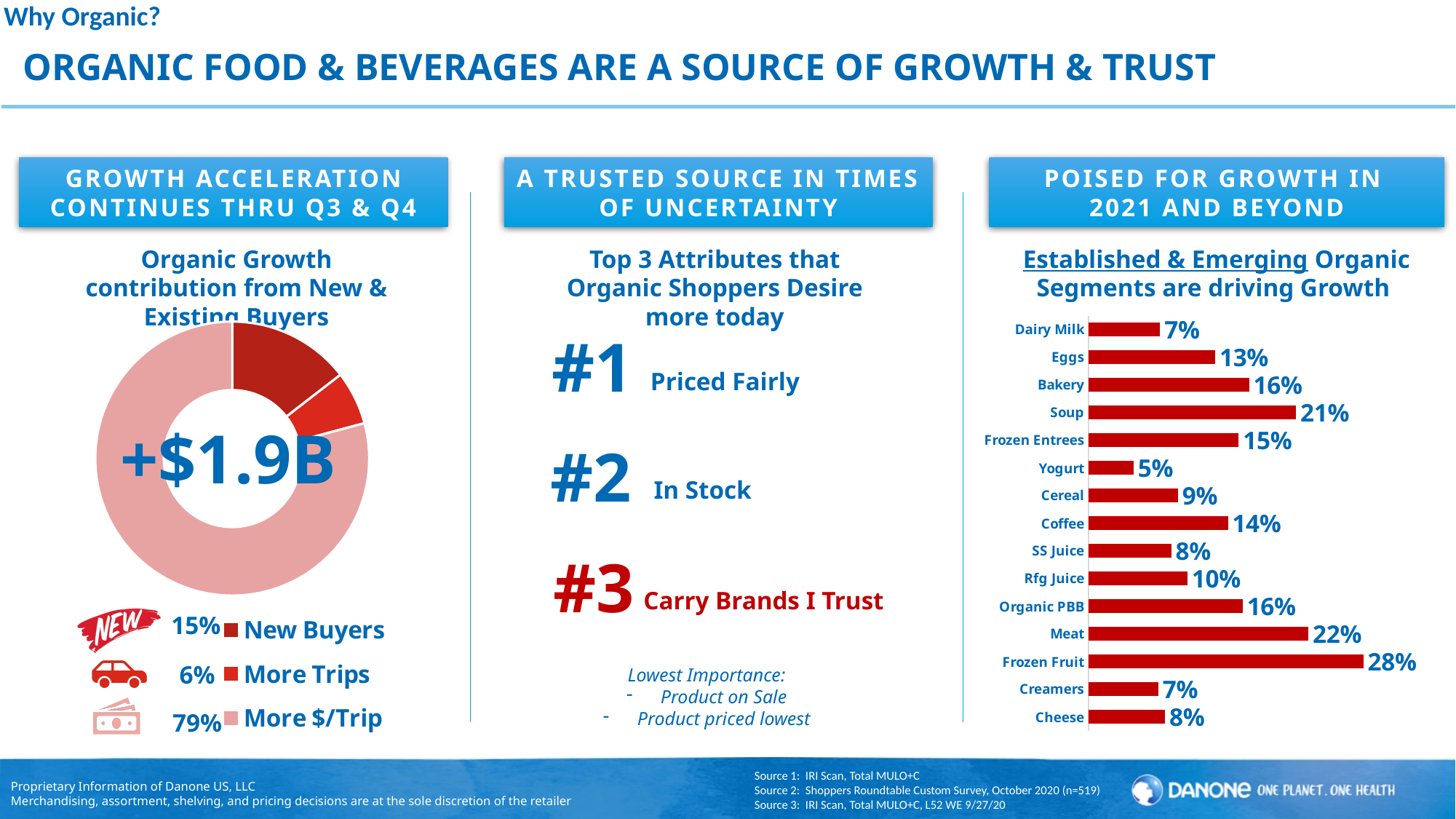
On the bar chart on the right, what is the difference between the values for Meat and Dairy Milk? 15% On the donut chart on the left, what is the value for New Buyers? 15% What kind of chart is shown on the right side of the slide under 'Established & Emerging Organic Segments are driving Growth'? Bar chart On the bar chart on the right, what is the value for Frozen Fruit? 28% On the bar chart on the right, which is larger, the value for Coffee or the value for Cereal? Coffee How many categories are shown on the bar chart on the right? 15 On the donut chart on the left, which segment is the smallest? More Trips What figure is printed in the center of the donut chart on the left? +$1.9B On the bar chart on the right, which category has the lowest value? Yogurt On the donut chart on the left, what share is attributed to More $/Trip? 79% On the bar chart on the right, which category has the highest value? Frozen Fruit On the bar chart on the right, what is the value for Soup? 21%